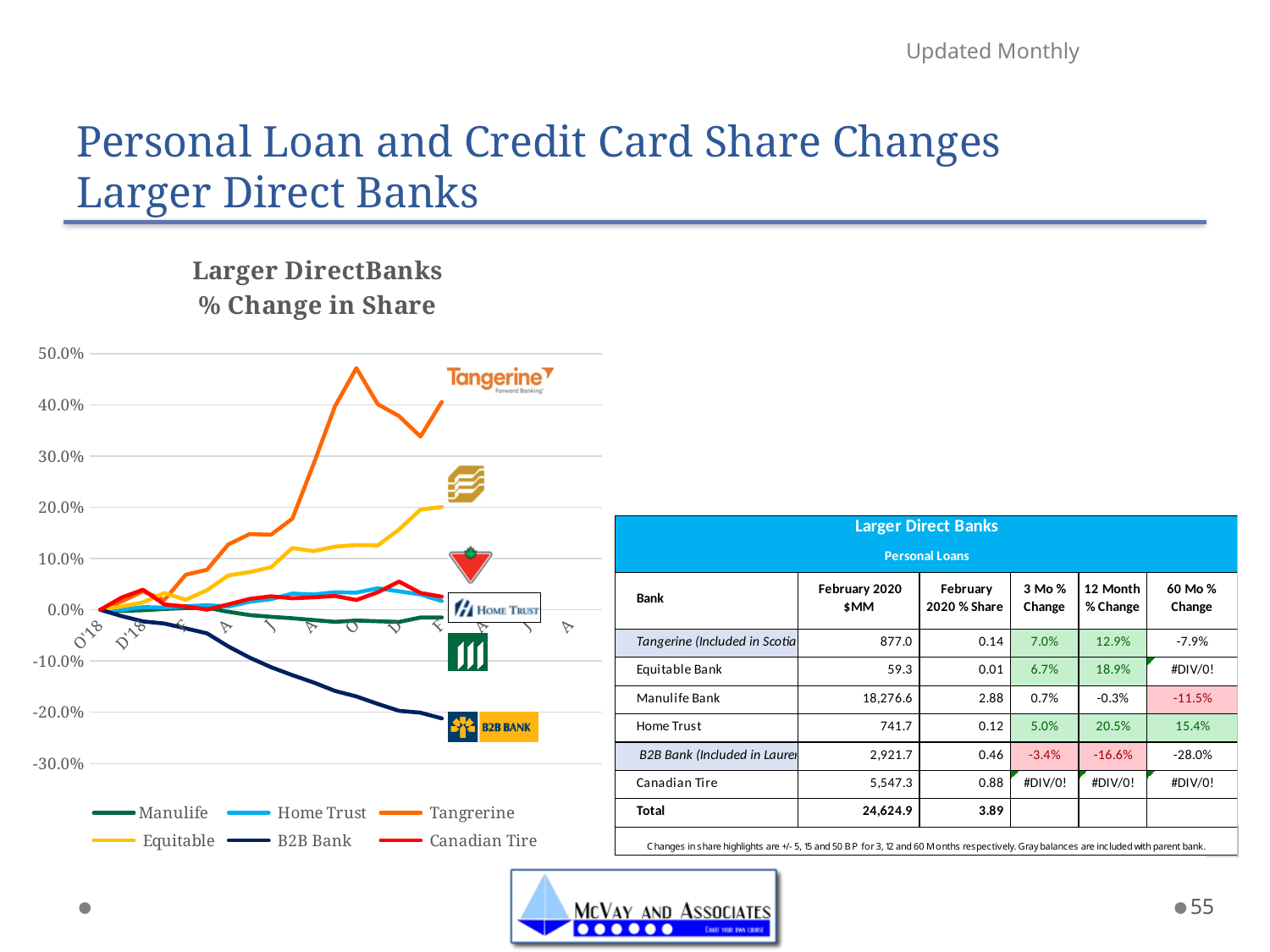
At the end of the period, which is larger: the Tangerine value or the Equitable value? Tangerine Is the final value of the Equitable line greater or less than 10.0%? greater What is the title of the chart? Larger DirectBanks % Change in Share Is the final value of the B2B Bank line greater or less than -10.0%? less What colour is the Tangerine line on the chart? Orange Does the B2B Bank line rise or fall over the period shown? Fall Is the peak value of the Tangerine line greater or less than 40.0%? greater What kind of chart is shown on the slide? Line chart Which series reaches the lowest value on the chart? B2B Bank How many series does the chart legend list? 6 Which series reaches the highest value on the chart? Tangerine